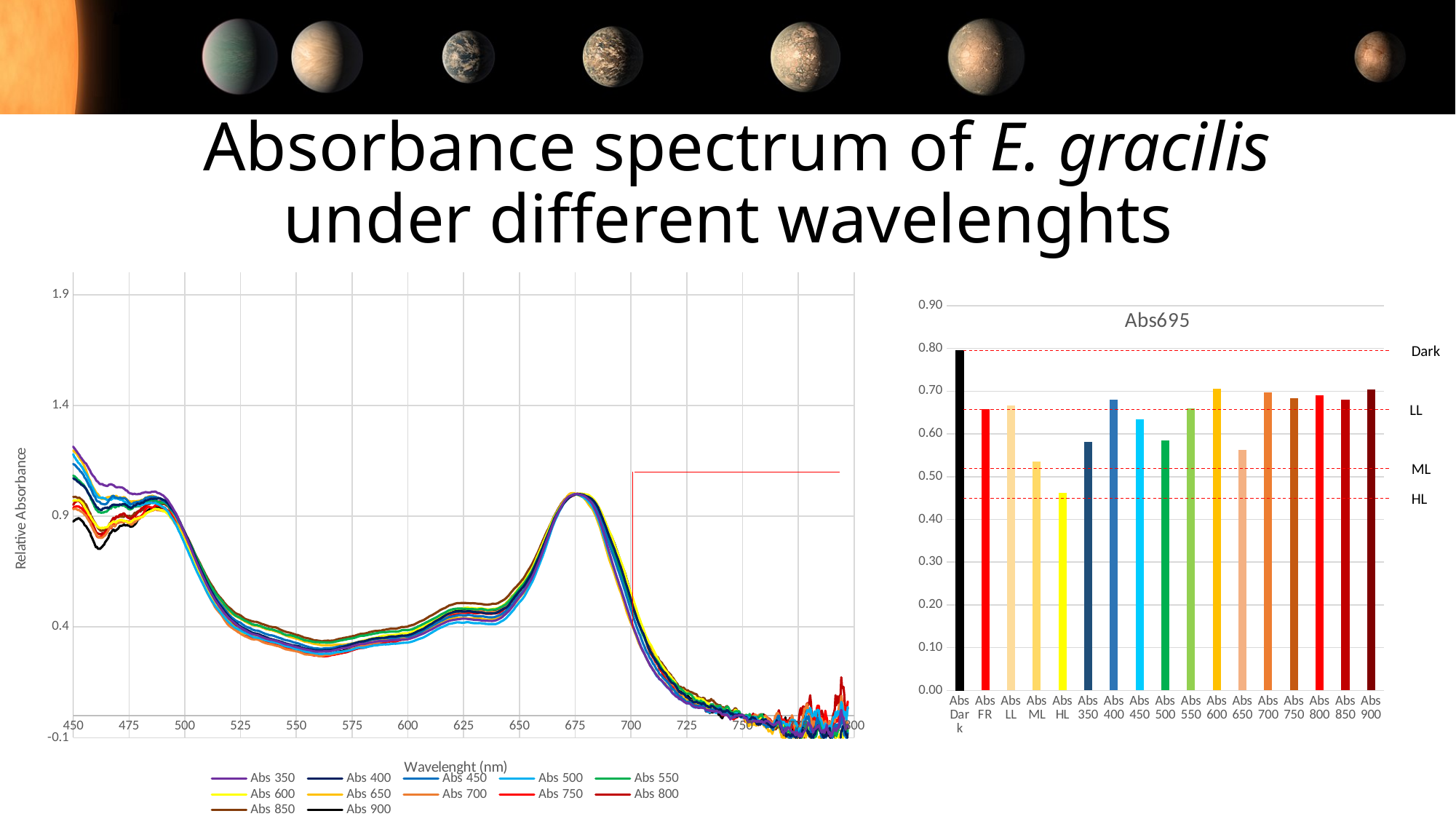
How many bars are plotted in the Abs695 chart? 17 How many series does the legend of the left line chart list? 12 What kind of chart is the chart titled Abs695 on the right of the slide? bar chart In the left line chart, do the absorbance values rise or fall between 500 nm and 550 nm on the x axis? fall What kind of chart is the chart on the left of the slide? line chart In the Abs695 chart, is the value for Abs HL greater or less than 0.50? less In the Abs695 chart, which category has the highest bar? Abs Dark In the Abs695 chart, which is larger, the bar for Abs 400 or the bar for Abs 450? Abs 400 What is the label of the x axis of the left line chart? Wavelenght (nm) In the Abs695 chart, is the value for Abs ML greater or less than 0.60? less In the Abs695 chart, is the value for Abs Dark greater or less than 0.70? greater In the Abs695 chart, which category has the lowest bar? Abs HL